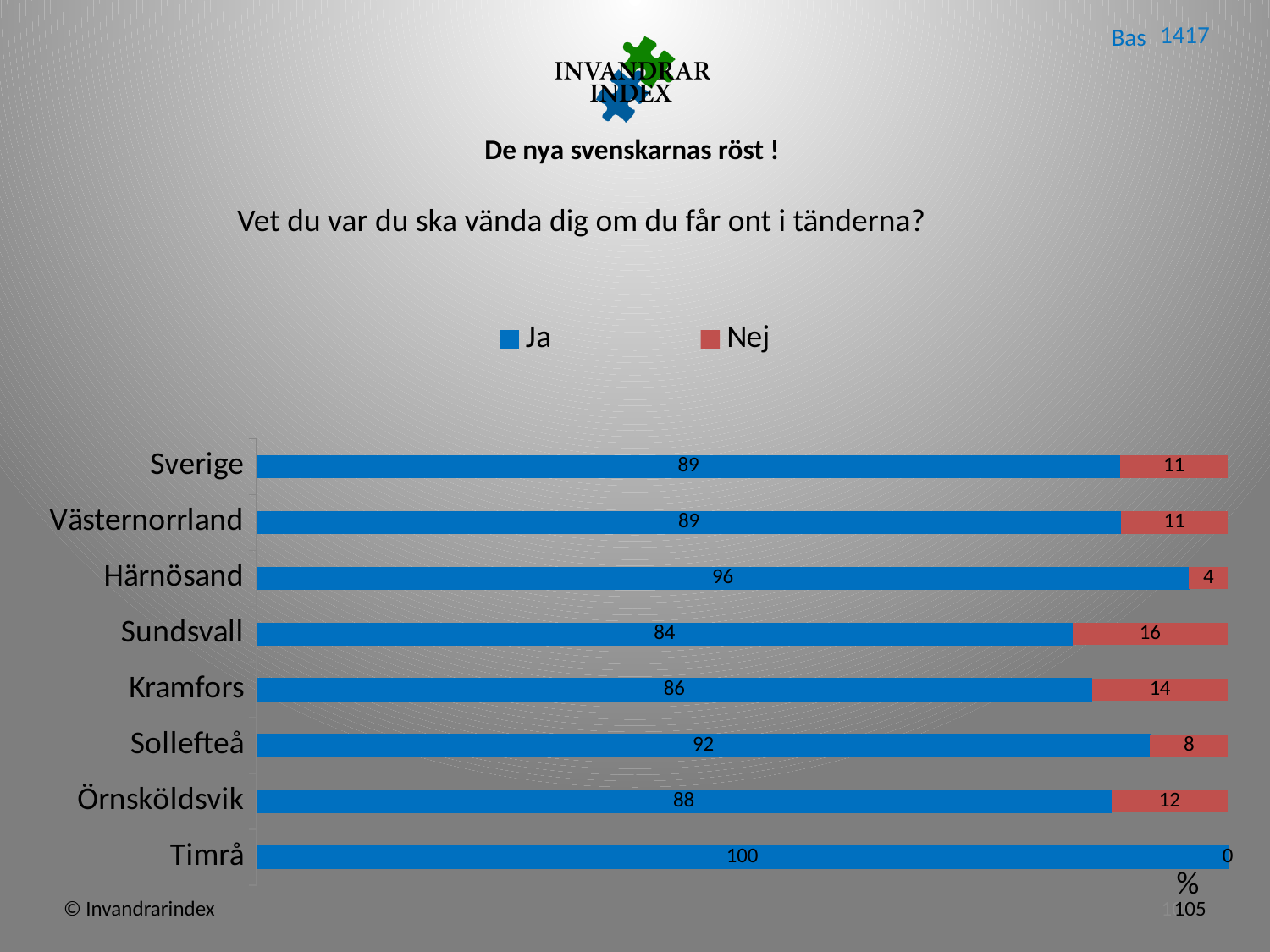
What is the difference between the Ja values for Sollefteå and Kramfors? 6 Which is larger, the Nej value for Kramfors or the Nej value for Örnsköldsvik? Kramfors Which category has the highest value for Ja? Timrå Which category has the lowest value for Ja? Sundsvall How many series does the legend list? 2 What is the value for Ja for Härnösand? 96 What is the value for Nej for Sundsvall? 16 What is the value for Ja for Örnsköldsvik? 88 Which category has the highest value for Nej? Sundsvall How many categories are shown in the chart? 8 What kind of chart is shown on the slide? Bar chart What is the total of the stacked bar for Sverige? 100